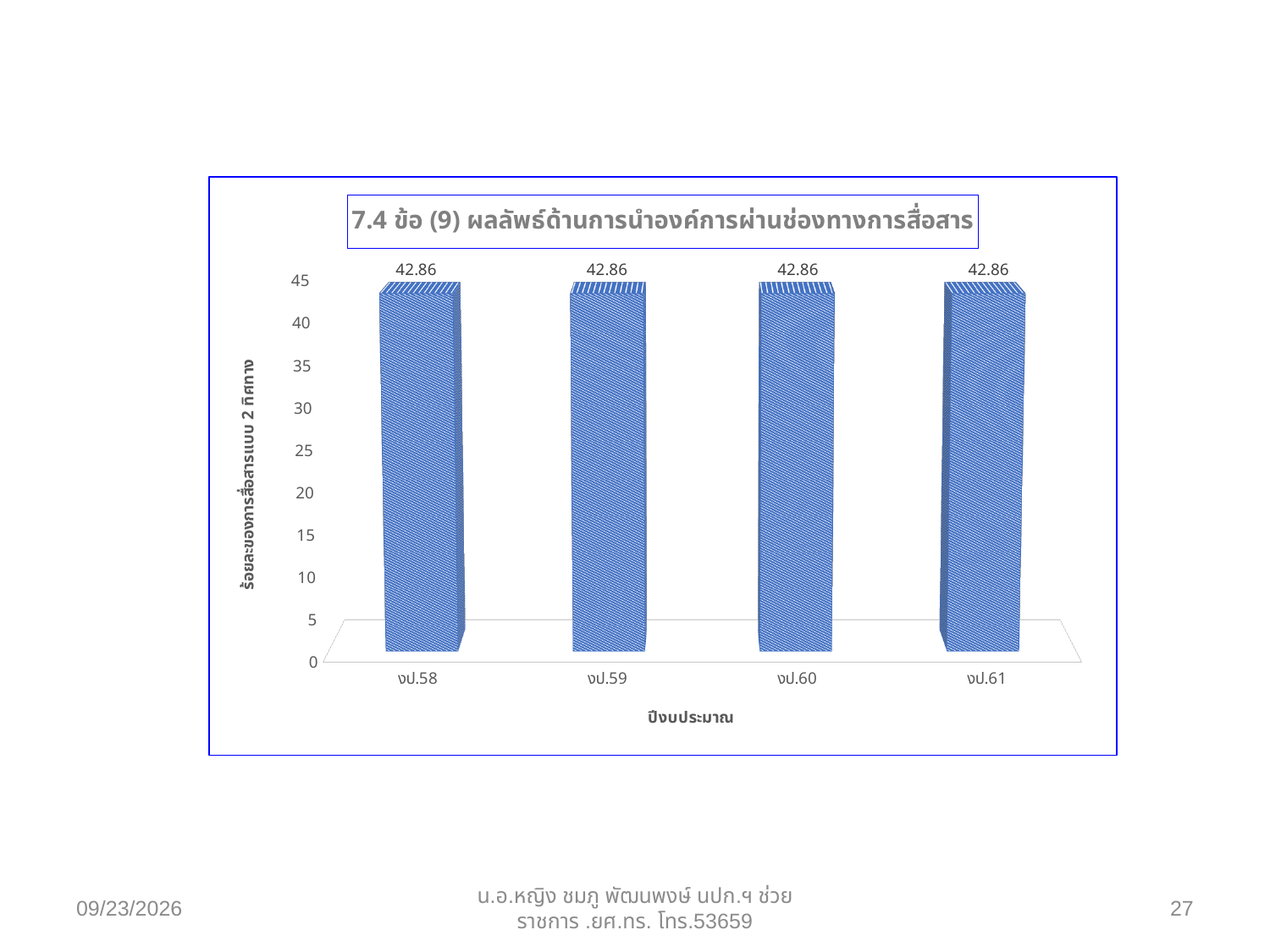
What is the title of the chart? 7.4 ข้อ (9) ผลลัพธ์ด้านการนำองค์การผ่านช่องทางการสื่อสาร What is the difference between the values for งป.58 and งป.61? 0 What kind of chart is shown on the slide? bar chart What is the value for งป.61? 42.86 Is the value for งป.59 greater or less than 45? less What is the value for งป.59? 42.86 Is the value for งป.60 greater or less than 40? greater What is the value for งป.60? 42.86 What is the label of the x axis? ปีงบประมาณ How many categories are shown on the x axis? 4 Do the values rise, fall, or stay the same from งป.58 to งป.61? stay the same What is the value for งป.58? 42.86